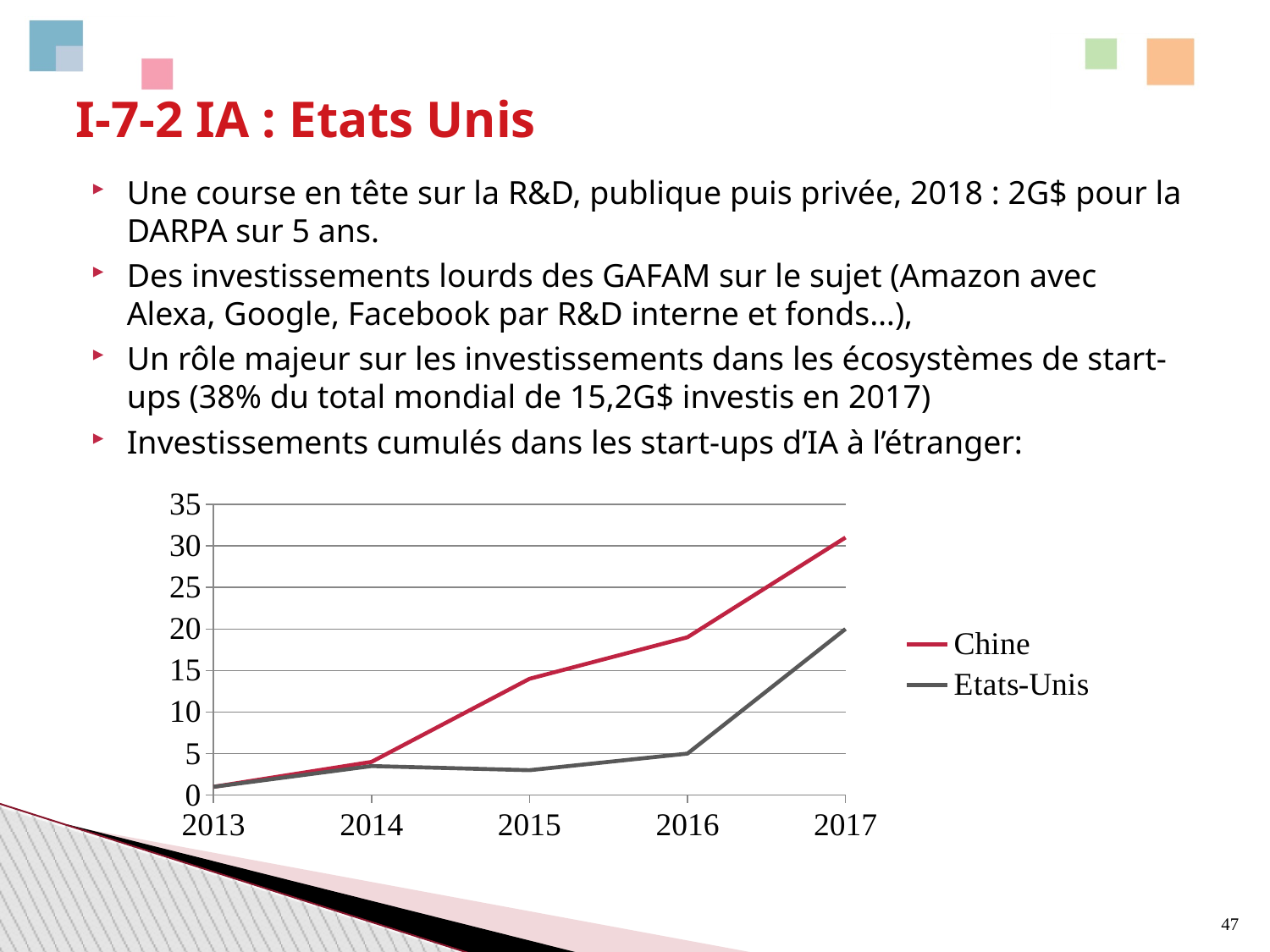
Does the Chine series rise or fall from 2013 to 2017? rise Is the value for Etats-Unis in 2015 greater or less than 5? less In which year does the Chine series reach its highest value? 2017 What kind of chart is shown on the slide? line chart How many series does the chart legend list? 2 Which series is drawn in red in the chart? Chine In which year is the Etats-Unis series at its lowest value? 2013 Is the value for Chine in 2017 greater or less than 25? greater Is the value for Chine in 2015 greater or less than 10? greater In 2017, which series has the larger value, Chine or Etats-Unis? Chine How many years are shown on the x axis of the chart? 5